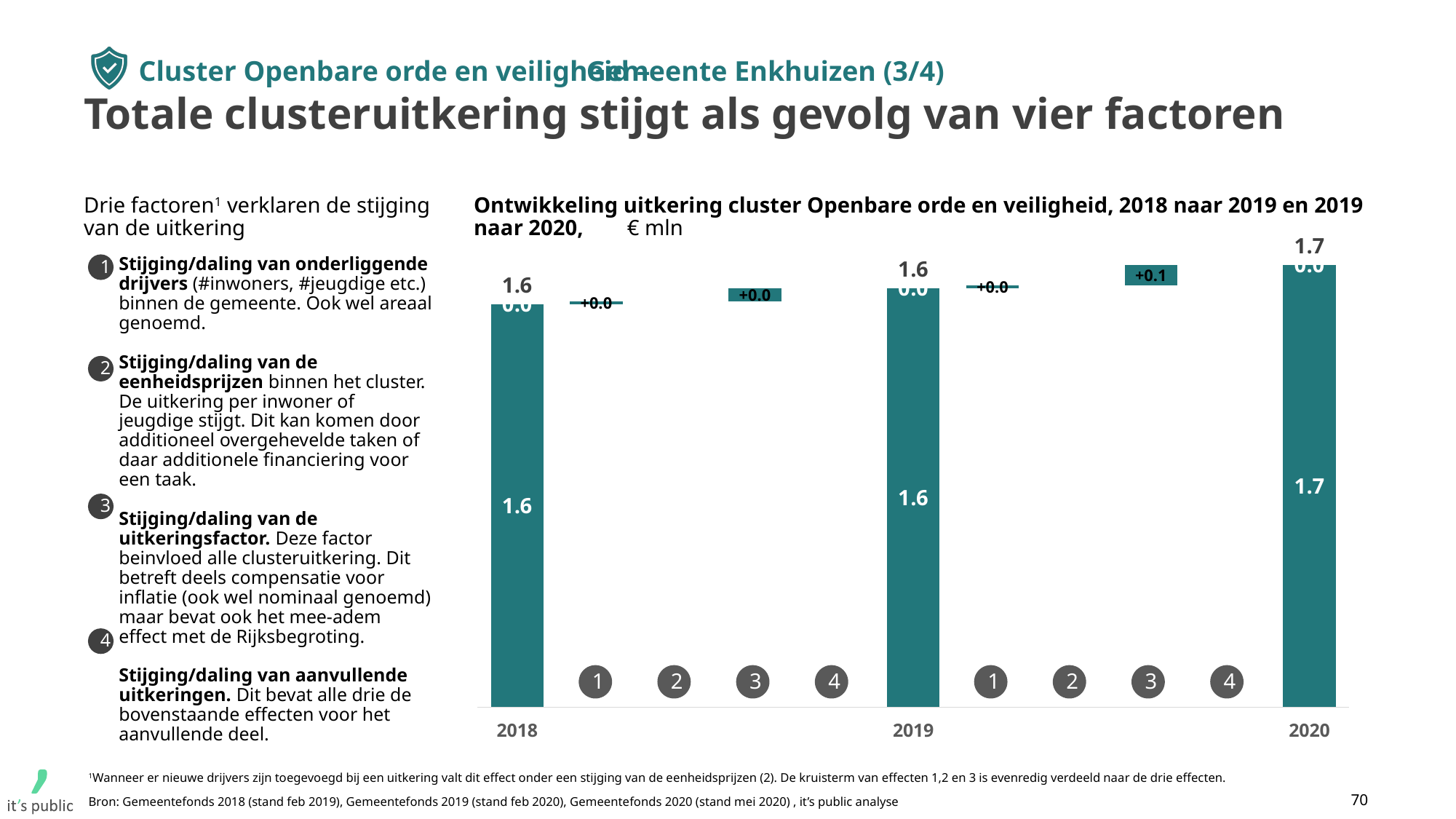
What is the labelled effect of factor 1 between 2019 and 2020? +0.0 What is the total cluster payment shown for 2020? 1.7 What is the labelled effect of factor 3 between 2019 and 2020? +0.1 Which year has the highest total cluster payment? 2020 Which is larger, the total for 2019 or the total for 2020? 2020 What is the difference between the total for 2020 and the total for 2018? 0.1 In what unit are the values in the chart expressed? € mln What is the total cluster payment shown for 2019? 1.6 What kind of chart is shown on the slide? bar chart What is the total cluster payment shown for 2018? 1.6 Do the total values rise or fall from 2018 to 2020? rise How many years are shown with a total bar in the chart? 3